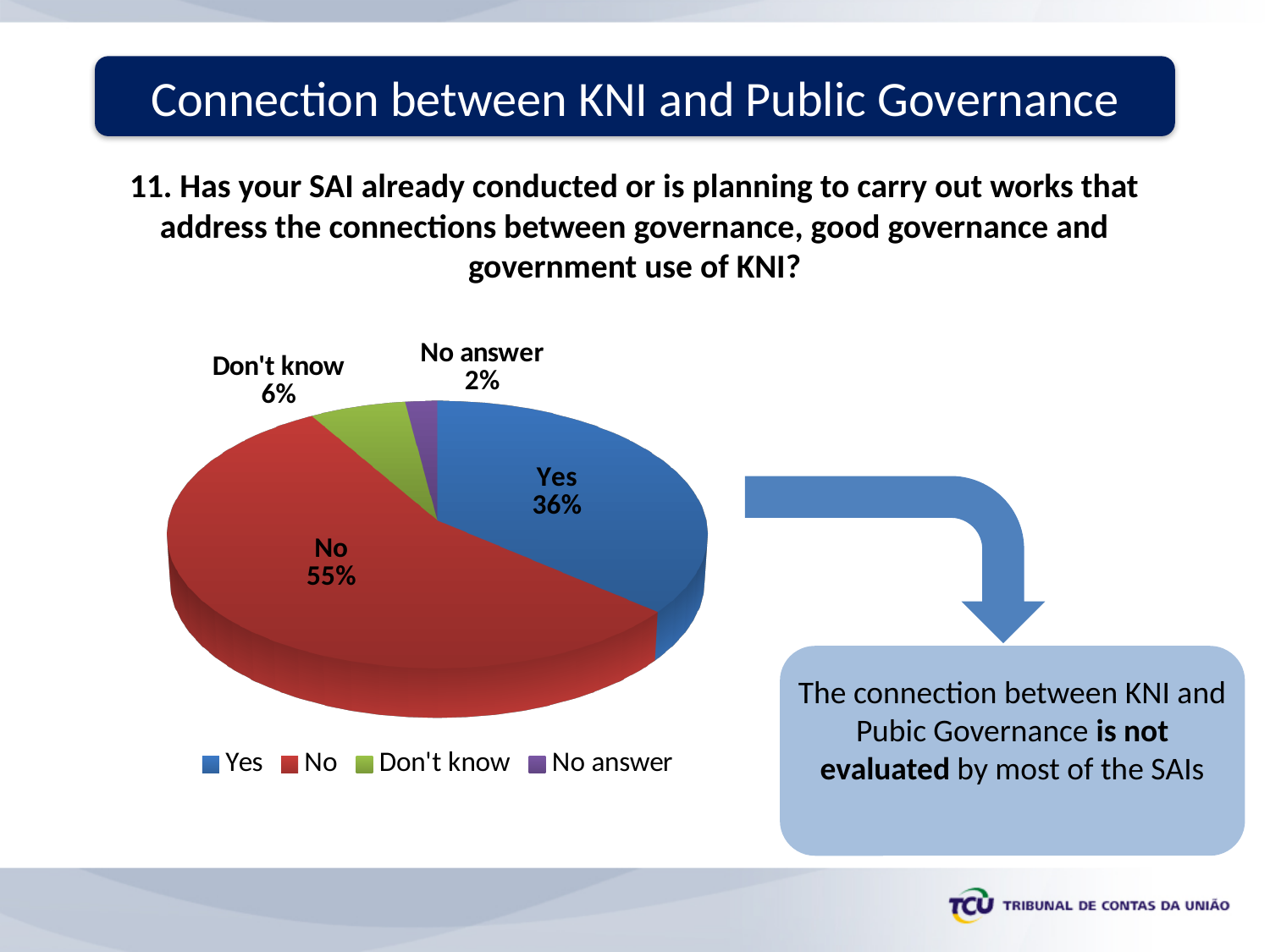
Which is larger, the "Yes" slice or the "Don't know" slice? Yes What share of the pie is "Don't know"? 6% Which response has the largest slice of the pie? No What percentage of respondents answered "Yes"? 36% What is the difference in percentage points between "No" and "Yes"? 19 What kind of chart is shown on the slide? Pie chart How many entries does the legend list? 4 What colour is the "No" slice in the pie chart? Red Which response has the smallest slice of the pie? No answer What share of the pie is "No answer"? 2% How many slices does the pie chart have? 4 What percentage of respondents answered "No"? 55%